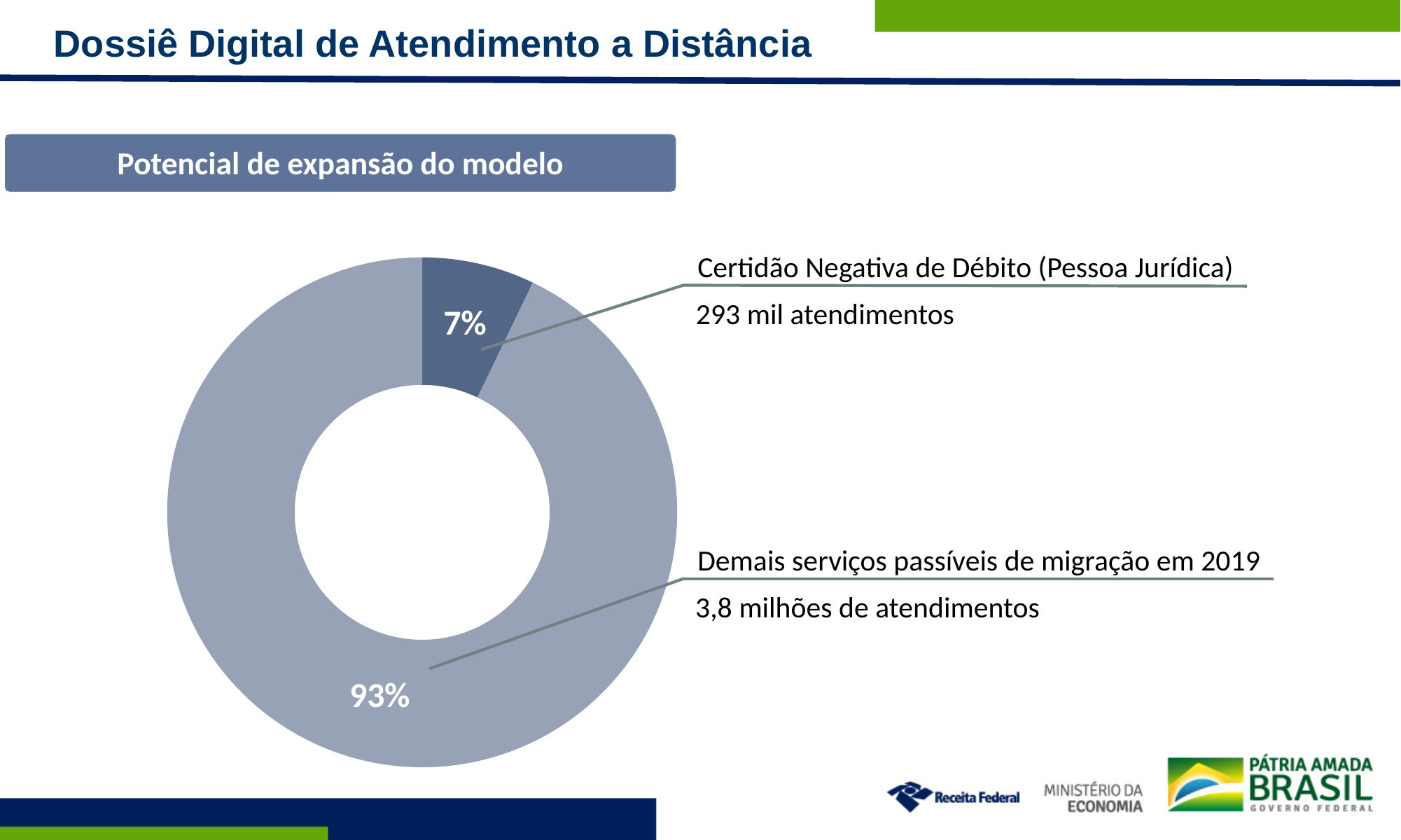
What share of the chart does "Certidão Negativa de Débito (Pessoa Jurídica)" represent? 7% Which slice is the smallest? Certidão Negativa de Débito (Pessoa Jurídica) What share of the chart does "Demais serviços passíveis de migração em 2019" represent? 93% How many atendimentos are stated for "Demais serviços passíveis de migração em 2019"? 3,8 milhões de atendimentos What is the heading shown above the chart? Potencial de expansão do modelo How many atendimentos are stated for "Certidão Negativa de Débito (Pessoa Jurídica)"? 293 mil atendimentos Which slice is the largest? Demais serviços passíveis de migração em 2019 Which is larger: the share for "Certidão Negativa de Débito (Pessoa Jurídica)" or for "Demais serviços passíveis de migração em 2019"? Demais serviços passíveis de migração em 2019 How many slices does the chart have? 2 What kind of chart is shown on the slide? Doughnut (pie) chart Which slice is drawn in the darker blue colour? Certidão Negativa de Débito (Pessoa Jurídica) What is the difference in percentage points between the two slices? 86 percentage points